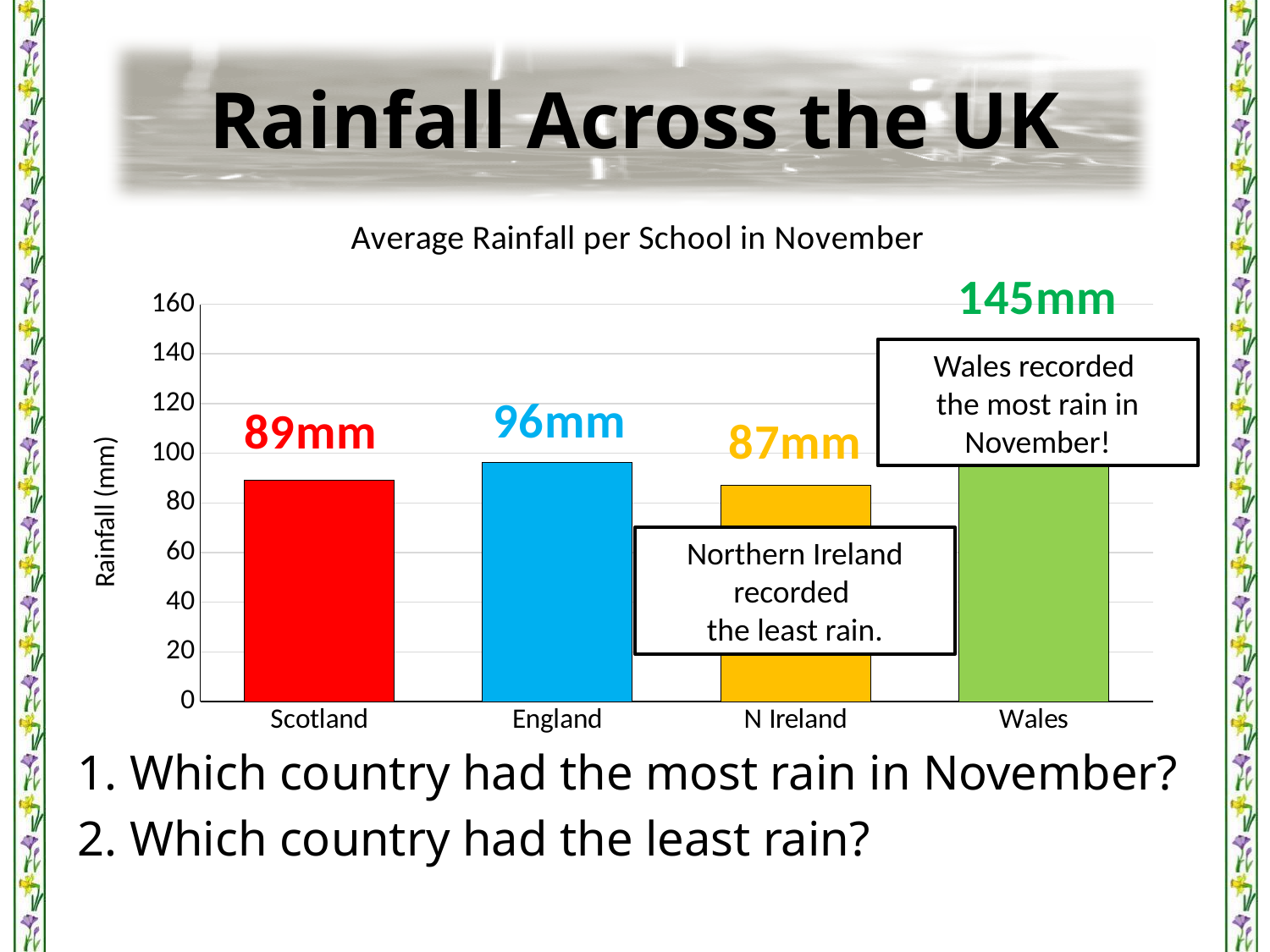
What is the average rainfall for Scotland? 89mm Which has more rainfall, Wales or Scotland? Wales What is the average rainfall for Wales? 145mm Is the value for Wales greater or less than 140? greater What is the average rainfall for England? 96mm How many countries are shown on the chart? 4 What is the average rainfall for N Ireland? 87mm What type of chart is shown on the slide? Bar chart What is the difference in rainfall between Scotland and N Ireland? 2mm Which country has the lowest average rainfall? N Ireland What is the difference in rainfall between Wales and England? 49mm Which country has the highest average rainfall? Wales